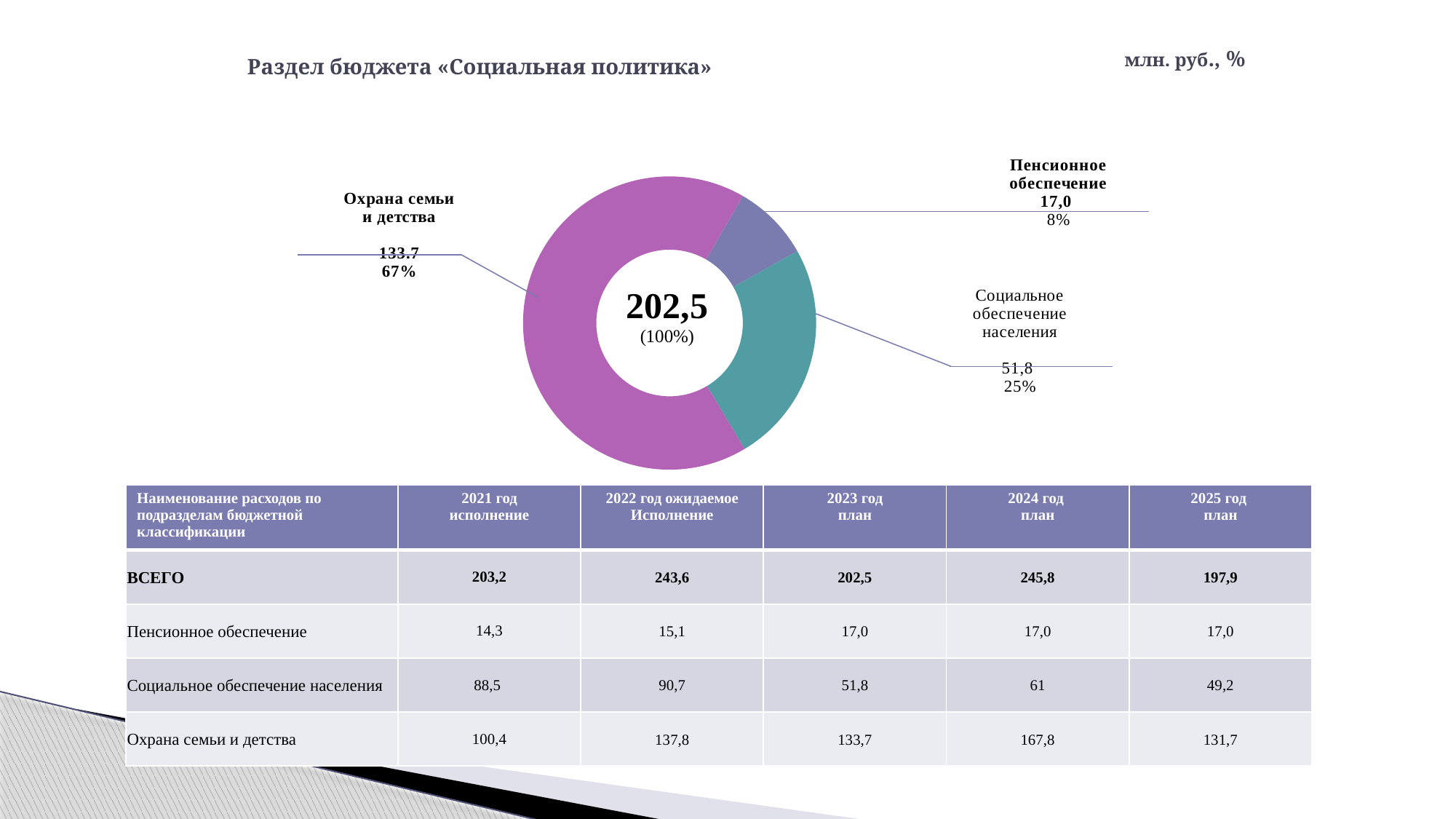
What is the difference between the values for Социальное обеспечение населения and Пенсионное обеспечение in the donut chart? 34,8 What is the value shown for Социальное обеспечение населения in the donut chart? 51,8 What is the value shown for Пенсионное обеспечение in the donut chart? 17,0 Which category has the smallest slice in the donut chart? Пенсионное обеспечение What kind of chart is shown on the slide? Donut (pie) chart Which category has the largest slice in the donut chart? Охрана семьи и детства How many slices does the donut chart have? 3 What share of the donut chart does Пенсионное обеспечение represent? 8% What share of the donut chart does Социальное обеспечение населения represent? 25% What total value is shown in the centre of the donut chart? 202,5 What share of the donut chart does Охрана семьи и детства represent? 67% Which is larger in the donut chart: Социальное обеспечение населения or Пенсионное обеспечение? Социальное обеспечение населения